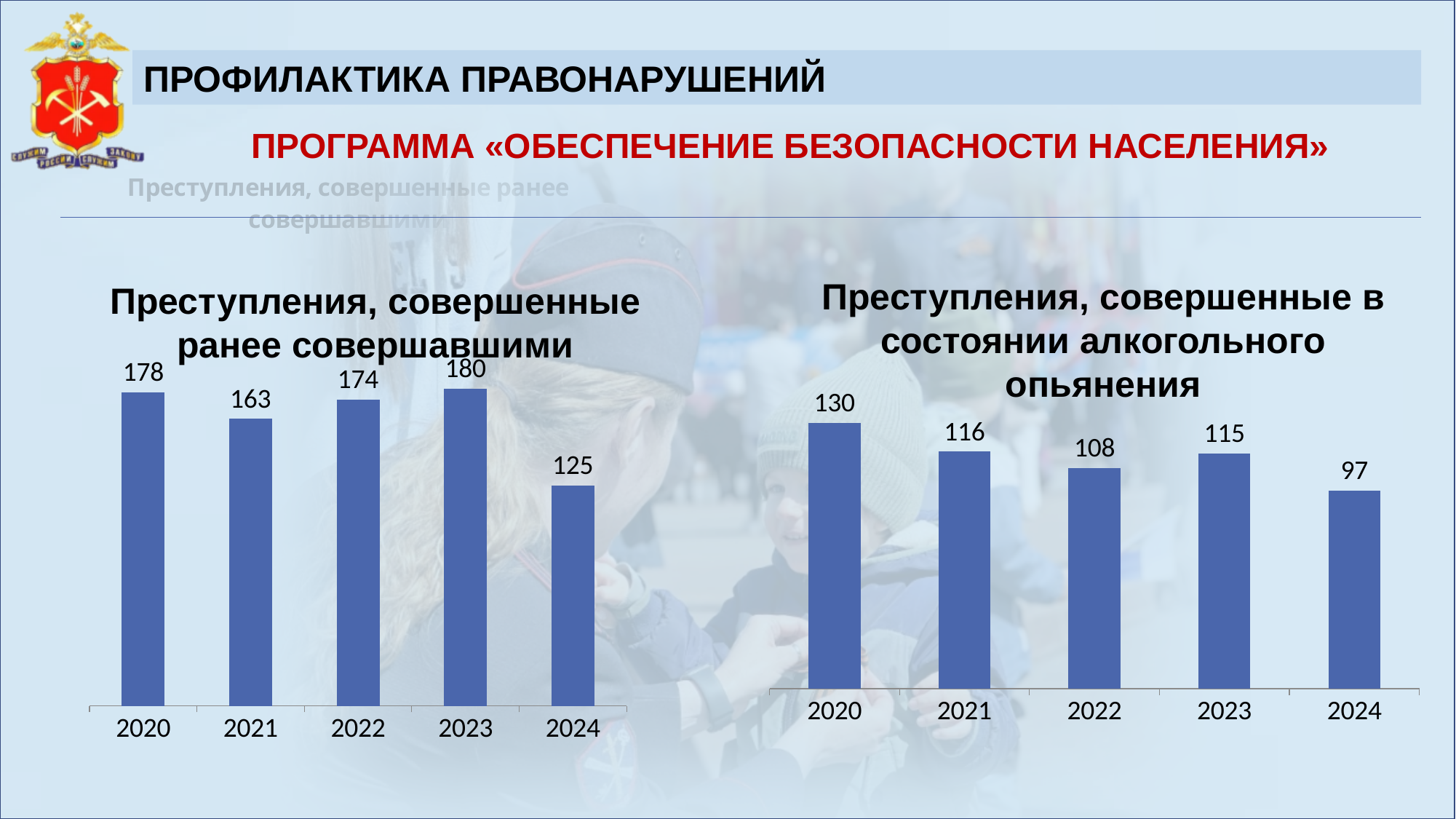
In the right chart 'Преступления, совершенные в состоянии алкогольного опьянения', which year has the lowest value? 2024 In the right chart 'Преступления, совершенные в состоянии алкогольного опьянения', which is larger, the value for 2021 or the value for 2022? 2021 How many years are shown on the x axis of the left chart 'Преступления, совершенные ранее совершавшими'? 5 In the left chart 'Преступления, совершенные ранее совершавшими', what is the difference between the values for 2023 and 2024? 55 In the left chart 'Преступления, совершенные ранее совершавшими', what is the value for 2024? 125 In the right chart 'Преступления, совершенные в состоянии алкогольного опьянения', what is the value for 2022? 108 In the left chart 'Преступления, совершенные ранее совершавшими', what is the value for 2020? 178 In the right chart 'Преступления, совершенные в состоянии алкогольного опьянения', what is the difference between the values for 2020 and 2024? 33 In the left chart 'Преступления, совершенные ранее совершавшими', which year has the highest value? 2023 In the right chart 'Преступления, совершенные в состоянии алкогольного опьянения', which year has the highest value? 2020 In the left chart 'Преступления, совершенные ранее совершавшими', which year has the lowest value? 2024 In the right chart 'Преступления, совершенные в состоянии алкогольного опьянения', what is the value for 2024? 97